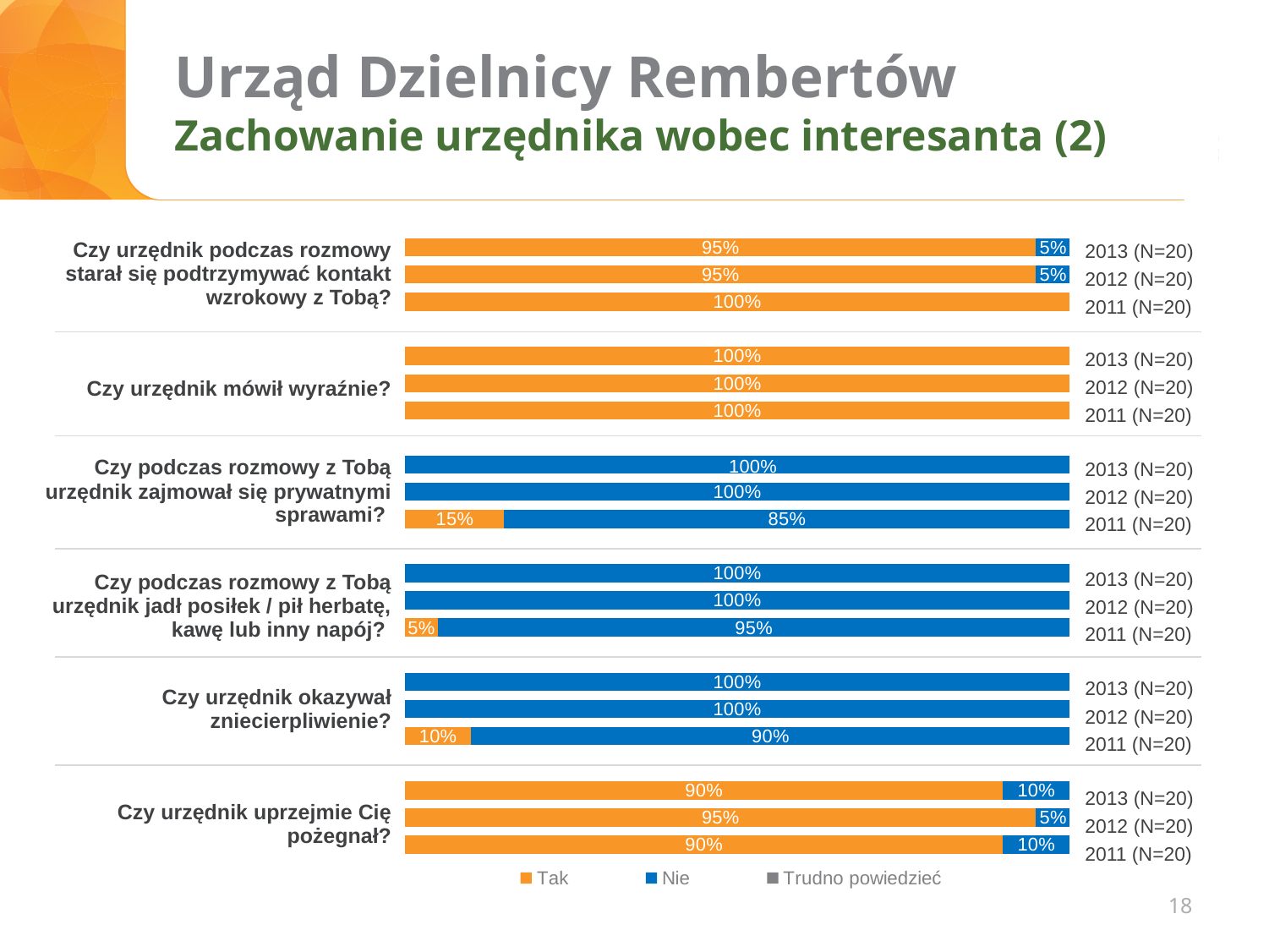
Which colour represents the 'Nie' series in the chart? blue For the question 'Czy podczas rozmowy z Tobą urzędnik jadł posiłek / pił herbatę, kawę lub inny napój?', which year has the lowest 'Nie' value? 2011 (N=20) What is the 'Tak' value for 2013 for the question 'Czy urzędnik podczas rozmowy starał się podtrzymywać kontakt wzrokowy z Tobą?' 95% For the question 'Czy podczas rozmowy z Tobą urzędnik zajmował się prywatnymi sprawami?', is the 'Tak' value for 2011 larger or smaller than the 'Tak' value for 2011 for 'Czy urzędnik okazywał zniecierpliwienie?' larger What is the 'Nie' value for 2011 for the question 'Czy podczas rozmowy z Tobą urzędnik zajmował się prywatnymi sprawami?' 85% For the question 'Czy urzędnik uprzejmie Cię pożegnał?', which year has the highest 'Tak' value? 2012 (N=20) What kind of chart is shown on the slide? stacked bar chart What is the 'Tak' value for 2011 for the question 'Czy urzędnik okazywał zniecierpliwienie?' 10% What is the 'Nie' value for 2013 for the question 'Czy urzędnik uprzejmie Cię pożegnał?' 10% How many series does the legend list? 3 What is the sample size (N) shown for each year in the chart? N=20 What is the difference between the 'Tak' values for 2012 and 2013 for the question 'Czy urzędnik uprzejmie Cię pożegnał?' 5%